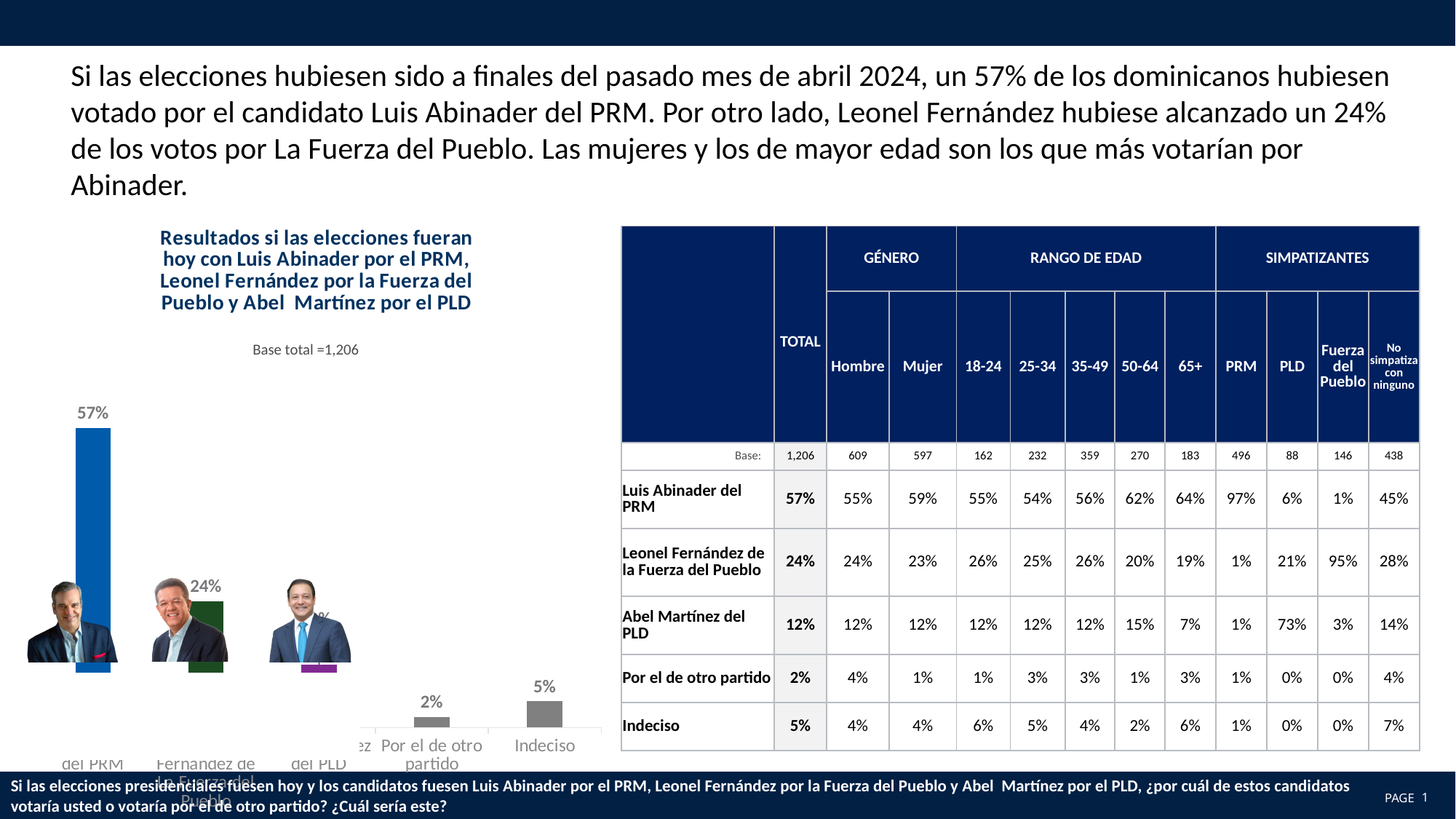
Which category has the lowest value in the bar chart? Por el de otro partido In the bar chart, what percentage is shown for Indeciso? 5% What is the difference between the values for Luis Abinader del PRM and Leonel Fernández de la Fuerza del Pueblo in the bar chart? 33% In the bar chart, what percentage is shown for Leonel Fernández de la Fuerza del Pueblo? 24% What is the base total stated under the bar chart's title? 1,206 What kind of chart is shown on the left of the slide? bar chart In the bar chart, what percentage is shown for Luis Abinader del PRM? 57% In the bar chart, which is larger: the value for Indeciso or the value for 'Por el de otro partido'? Indeciso In the bar chart, what percentage is shown for 'Por el de otro partido'? 2% What is the difference between the values for Indeciso and 'Por el de otro partido' in the bar chart? 3% Which category has the highest value in the bar chart? Luis Abinader del PRM How many categories (bars) are shown in the bar chart? 5